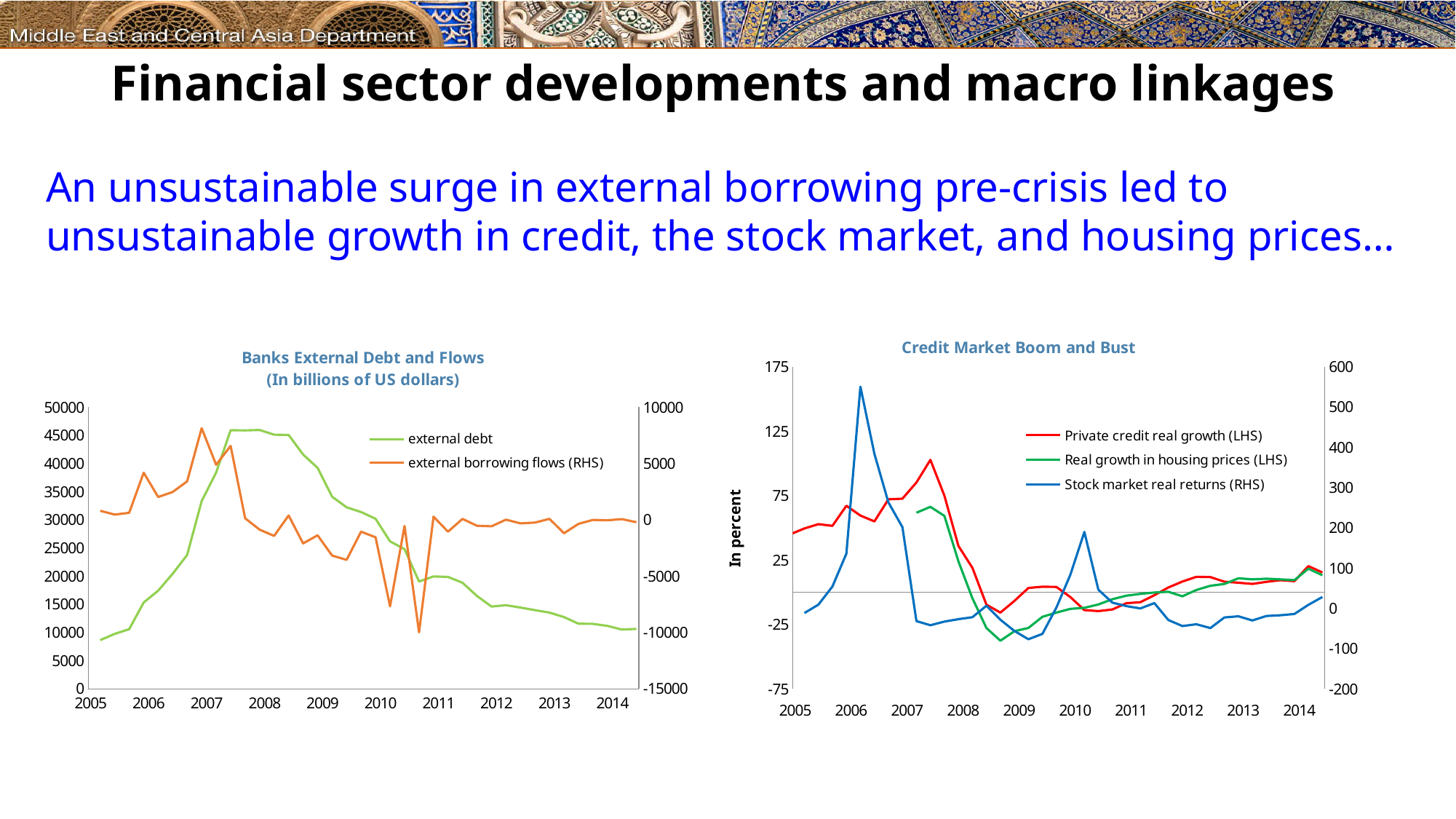
How many series does the legend of the 'Credit Market Boom and Bust' chart list? 3 In the 'Credit Market Boom and Bust' chart, which series is plotted on the right-hand axis (RHS)? Stock market real returns (RHS) What kind of chart is the 'Banks External Debt and Flows' chart? line chart What kind of chart is the 'Credit Market Boom and Bust' chart? line chart How many series does the legend of the 'Banks External Debt and Flows' chart list? 2 In the 'Banks External Debt and Flows' chart, is the value of external debt in 2012 greater or less than 20000? less In the 'Credit Market Boom and Bust' chart, is the peak value of stock market real returns in 2006 greater or less than 500 on the right-hand axis? greater In the 'Credit Market Boom and Bust' chart, is the peak value of private credit real growth in 2007 greater or less than 75 on the left-hand axis? greater What unit is given in the subtitle of the 'Banks External Debt and Flows' chart? In billions of US dollars In the 'Banks External Debt and Flows' chart, does external debt rise or fall between 2005 and 2008? rise In the 'Banks External Debt and Flows' chart, does external debt rise or fall between 2008 and 2014? fall